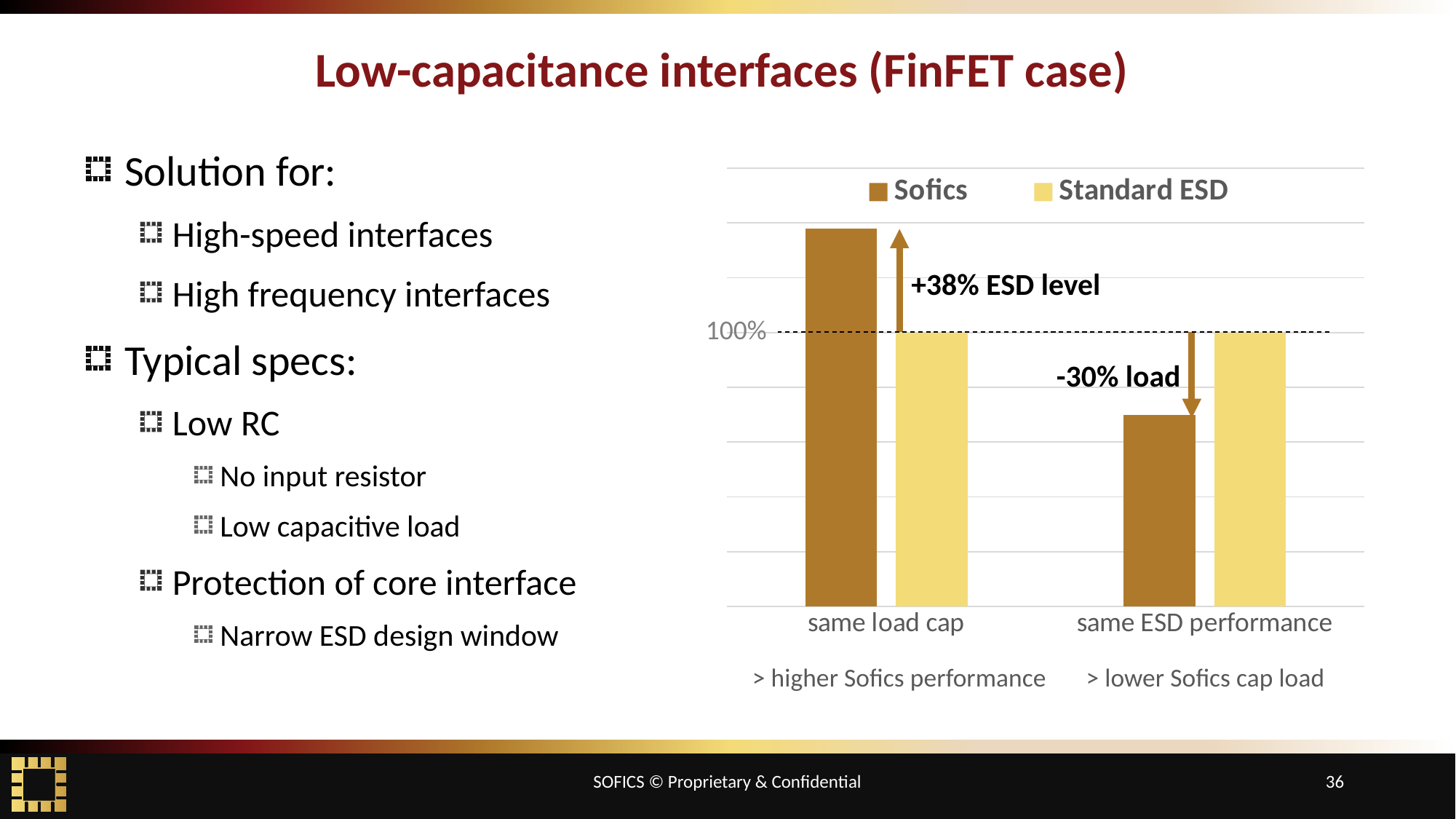
What are the two series named in the chart legend? Sofics and Standard ESD Which bar in the chart is the shortest? Sofics, same ESD performance Which bar in the chart is the tallest? Sofics, same load cap Is the Sofics value for 'same load cap' greater or less than 100%? greater Is the Sofics value for 'same ESD performance' greater or less than 100%? less For 'same ESD performance', which series has the taller bar, Sofics or Standard ESD? Standard ESD How many categories are shown on the x axis of the chart? 2 How many series does the chart legend list? 2 What is the value of the Standard ESD bar for 'same load cap'? 100% For 'same load cap', which series has the taller bar, Sofics or Standard ESD? Sofics What kind of chart is shown on the slide? bar chart What is the value of the Standard ESD bar for 'same ESD performance'? 100%